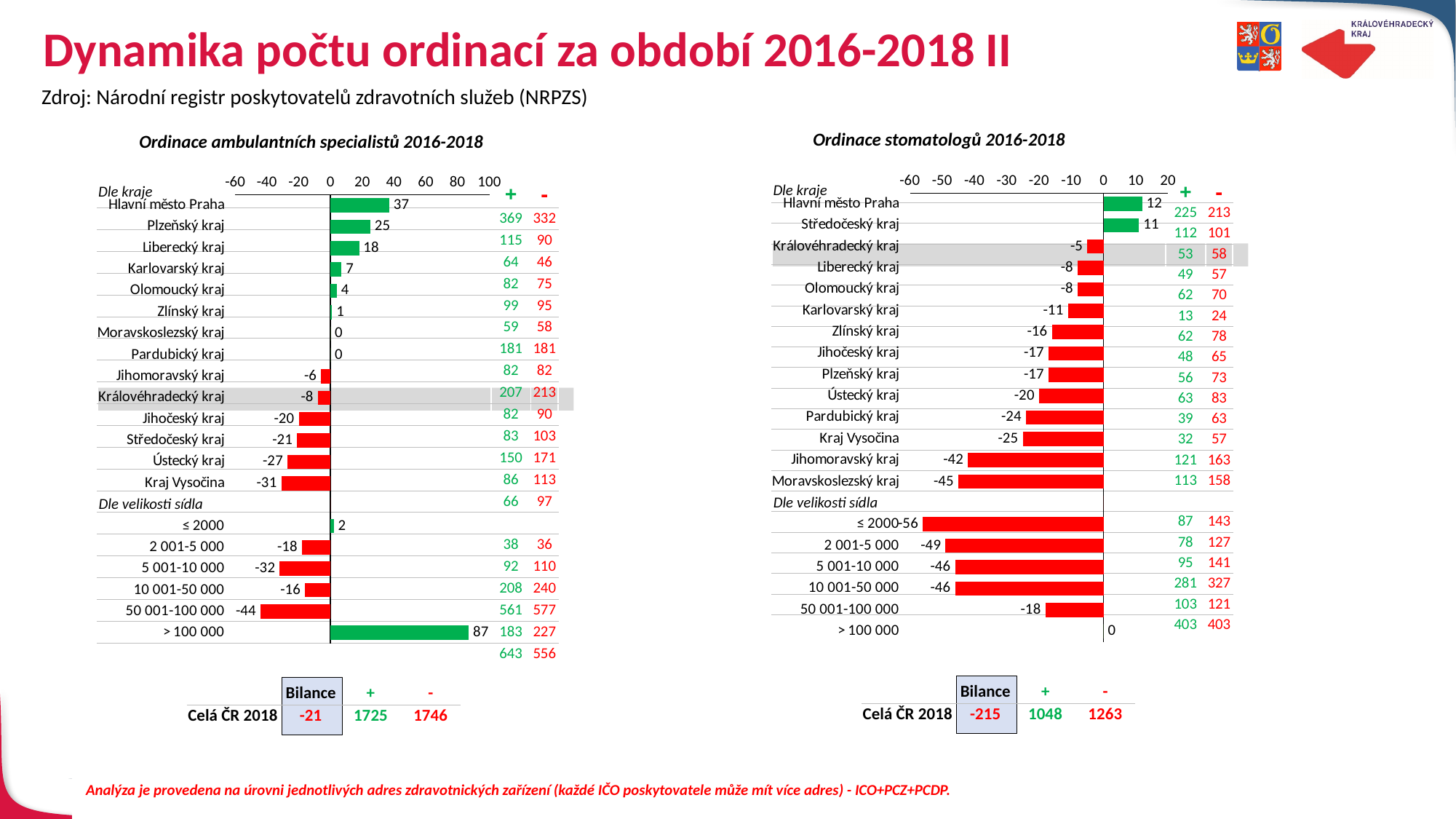
In the chart 'Ordinace ambulantních specialistů 2016-2018', what is the value for Hlavní město Praha? 37 In the chart 'Ordinace stomatologů 2016-2018', which region (Dle kraje) has the highest value? Hlavní město Praha What type of chart is 'Ordinace ambulantních specialistů 2016-2018'? Bar chart How many regions (Dle kraje) are listed in the chart 'Ordinace stomatologů 2016-2018'? 14 In the chart 'Ordinace ambulantních specialistů 2016-2018', what is the difference between the values for Plzeňský kraj and Liberecký kraj? 7 In the chart 'Ordinace ambulantních specialistů 2016-2018', what is the value for Kraj Vysočina? -31 In the chart 'Ordinace stomatologů 2016-2018', what is the value for Moravskoslezský kraj? -45 In the chart 'Ordinace ambulantních specialistů 2016-2018', which size-of-settlement category has the highest value? > 100 000 In the chart 'Ordinace stomatologů 2016-2018', which is larger, the value for Jihomoravský kraj or the value for Ústecký kraj? Ústecký kraj In the chart 'Ordinace ambulantních specialistů 2016-2018', which region (Dle kraje) has the lowest value? Kraj Vysočina In the chart 'Ordinace stomatologů 2016-2018', what is the value for Královéhradecký kraj? -5 In the chart 'Ordinace stomatologů 2016-2018', which size-of-settlement category has the lowest value? ≤ 2000